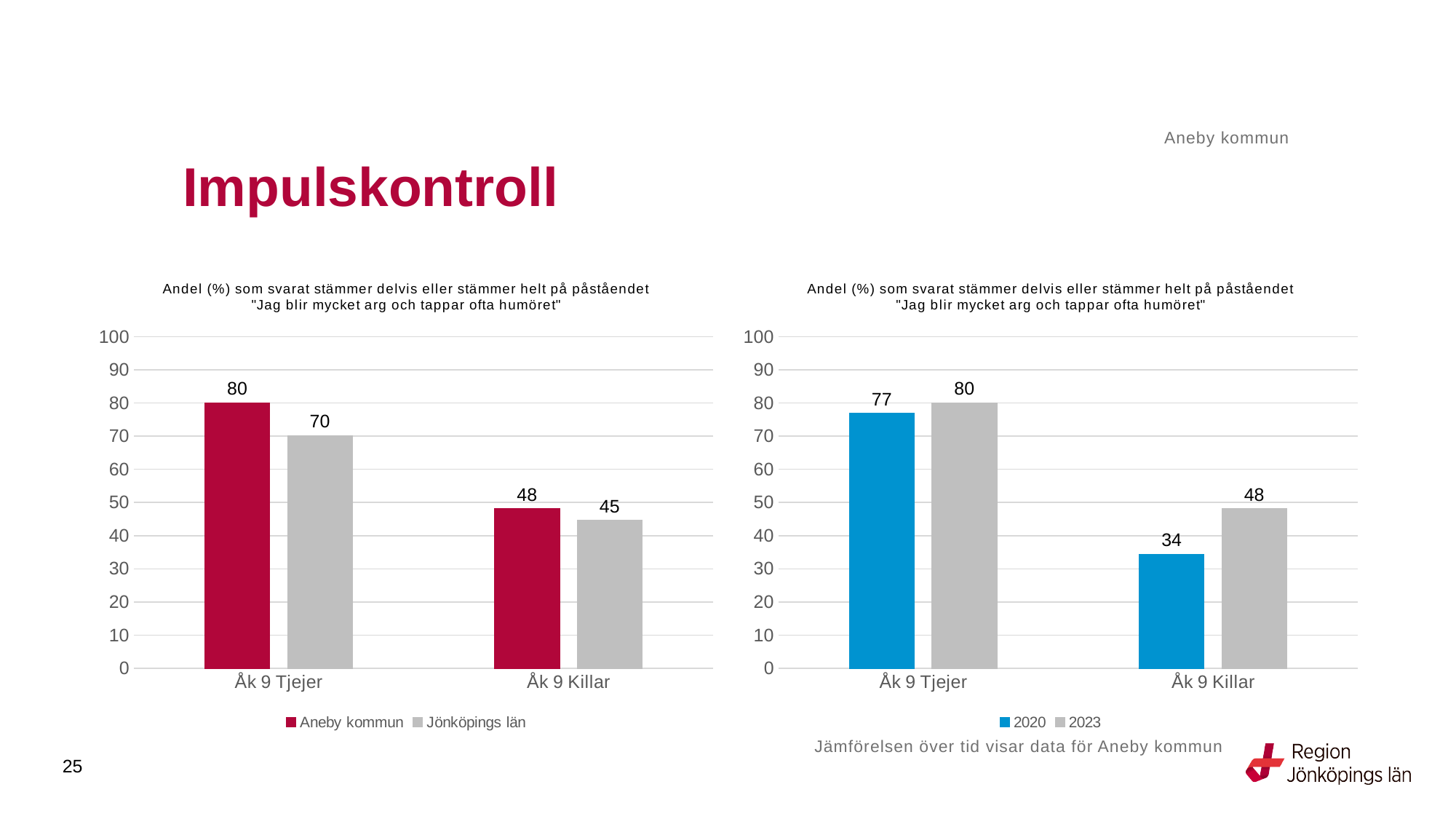
In the right chart, what is the difference between 2023 and 2020 for Åk 9 Killar? 14 In the left chart, what is the difference between Aneby kommun and Jönköpings län for Åk 9 Tjejer? 10 In the right chart, which bar has the highest value? 2023 for Åk 9 Tjejer What are the two series named in the legend of the right chart? 2020 and 2023 In the right chart, what is the value for 2023 for Åk 9 Tjejer? 80 In the left chart, which category has the lowest value for Jönköpings län? Åk 9 Killar In the right chart, what is the value for 2020 for Åk 9 Killar? 34 How many series does the legend of the left chart list? 2 In the right chart, which is larger for Åk 9 Tjejer, 2020 or 2023? 2023 In the left chart, what is the value for Jönköpings län for Åk 9 Killar? 45 In the left chart, what is the value for Aneby kommun for Åk 9 Tjejer? 80 What kind of chart is the right chart? Bar chart